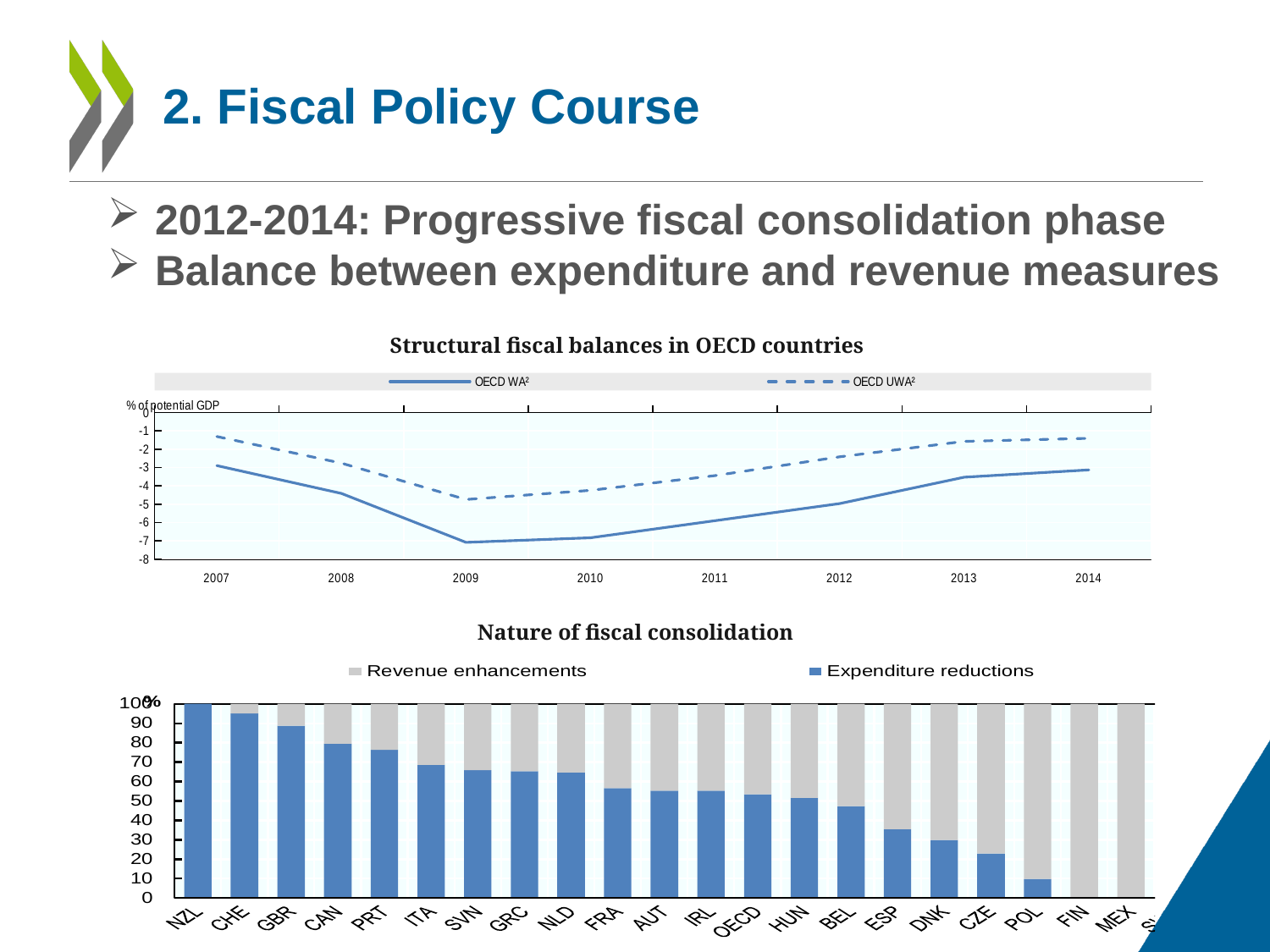
How many series does the legend of the 'Structural fiscal balances in OECD countries' chart list? 2 In the 'Structural fiscal balances in OECD countries' chart, in which year is the OECD WA series at its lowest? 2009 In the 'Nature of fiscal consolidation' chart, which has the larger expenditure reductions share, CAN or ESP? CAN In the 'Structural fiscal balances in OECD countries' chart, does the OECD WA series rise or fall from 2009 to 2014? rise What kind of chart is the 'Structural fiscal balances in OECD countries' chart? line chart In the 'Nature of fiscal consolidation' chart, which country has the highest share of expenditure reductions? NZL In the 'Nature of fiscal consolidation' chart, is the expenditure reductions value for CAN greater or less than 70? greater In the 'Structural fiscal balances in OECD countries' chart, how many years are shown on the x axis? 8 In the 'Structural fiscal balances in OECD countries' chart, is the OECD UWA value for 2007 greater or less than -2? greater In the 'Structural fiscal balances in OECD countries' chart, is the OECD WA value for 2009 greater or less than -6? less In the 'Structural fiscal balances in OECD countries' chart, which series is higher in 2011, OECD WA or OECD UWA? OECD UWA What kind of chart is the 'Nature of fiscal consolidation' chart? bar chart